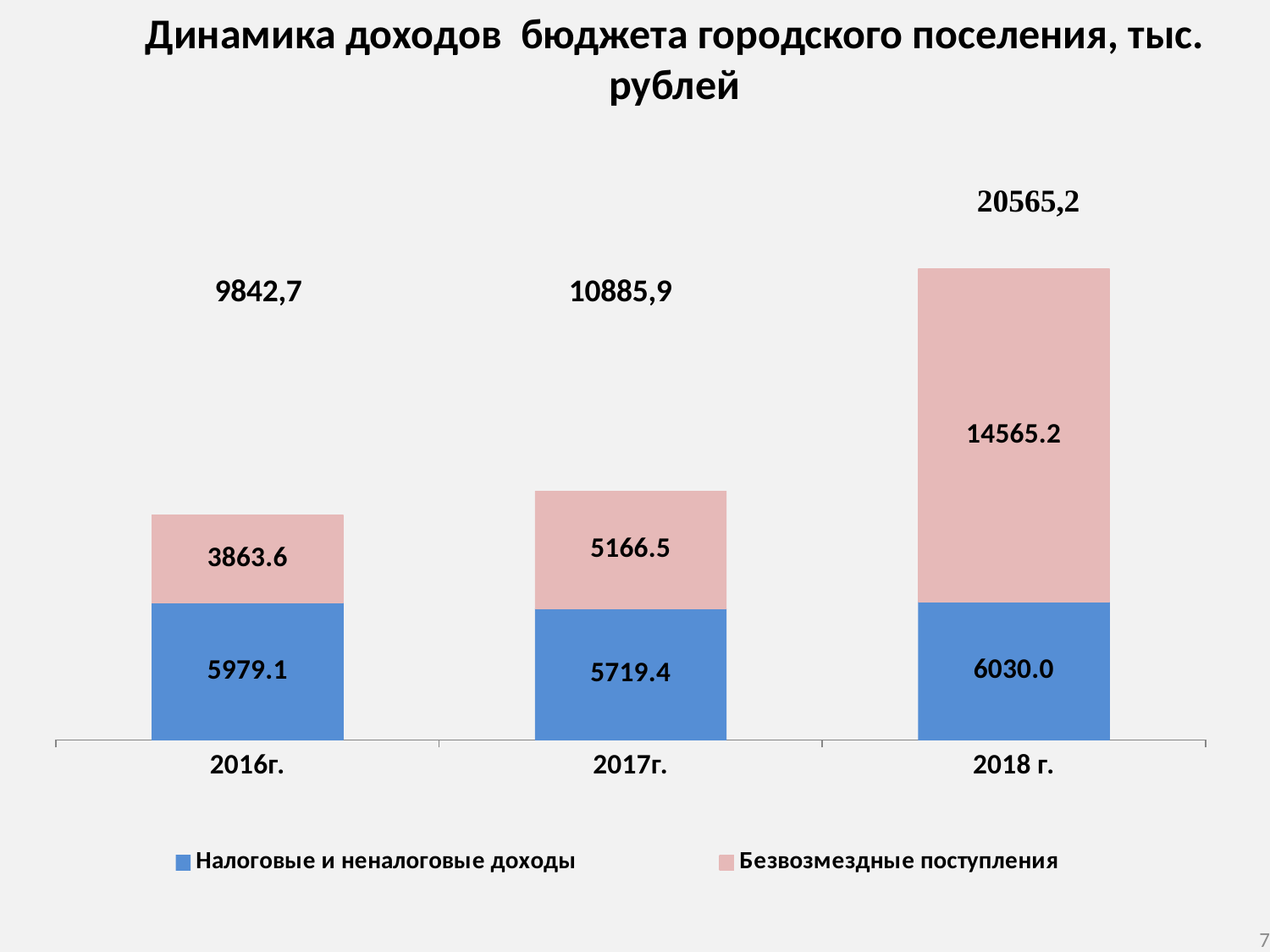
What kind of chart is shown on the slide? Stacked bar chart Which is larger in 2016г.: Налоговые и неналоговые доходы or Безвозмездные поступления? Налоговые и неналоговые доходы What is the total shown above the bar for 2018 г.? 20565,2 How many years are shown on the x axis? 3 What is the difference between Безвозмездные поступления in 2018 г. and 2017г.? 9398.7 What is the value of Налоговые и неналоговые доходы for 2016г.? 5979.1 Which year has the highest value of Безвозмездные поступления? 2018 г. What is the value of Безвозмездные поступления for 2017г.? 5166.5 What is the total shown above the bar for 2016г.? 9842,7 How many series does the legend list? 2 Which year has the lowest value of Налоговые и неналоговые доходы? 2017г. What is the value of Безвозмездные поступления for 2018 г.? 14565.2